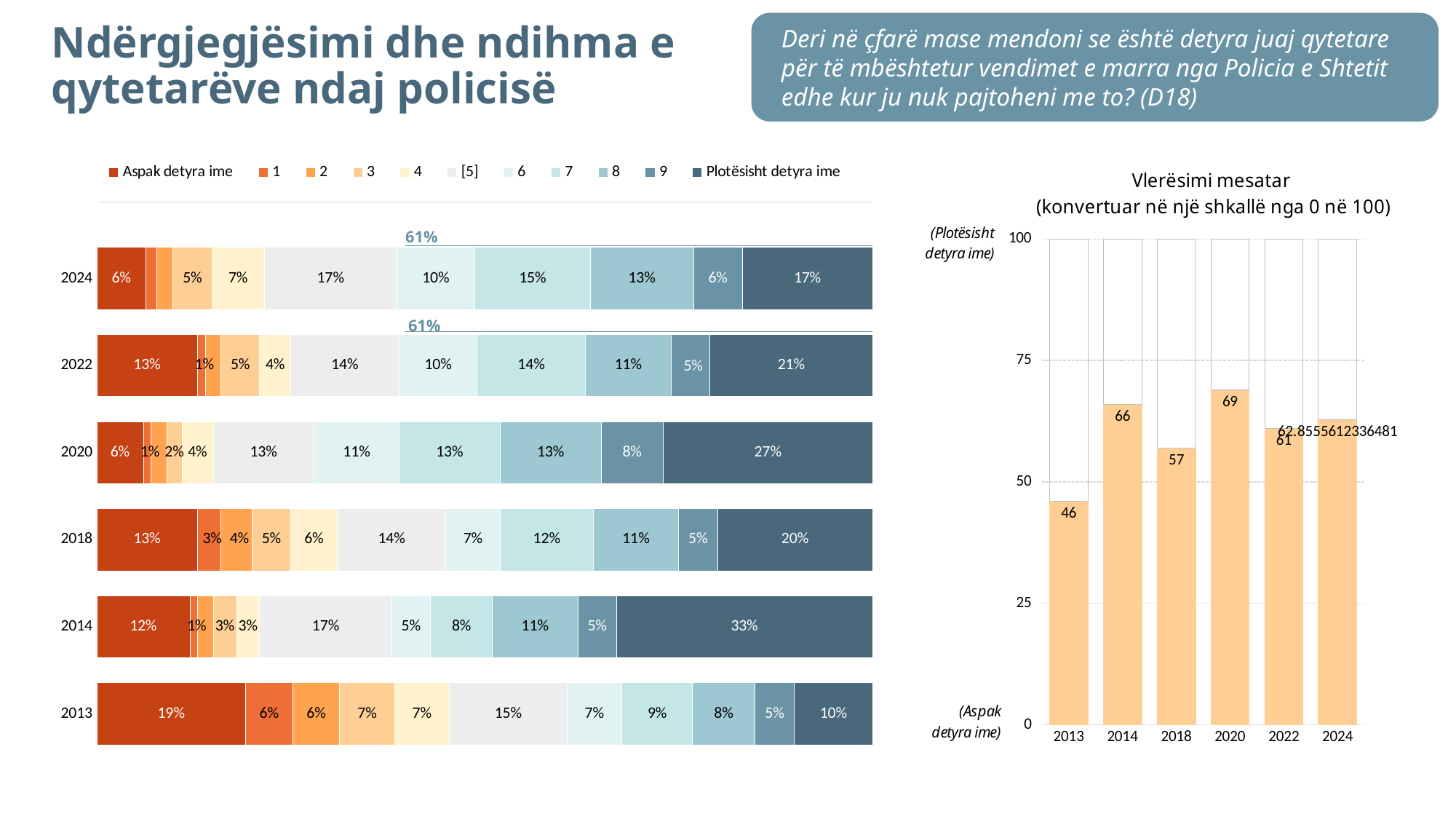
In the 'Vlerësimi mesatar' chart, what is the difference between the values for 2020 and 2018? 12 In the stacked bar chart on the left, which year has the largest 'Plotësisht detyra ime' share? 2014 In the stacked bar chart on the left, what is the 'Aspak detyra ime' share for 2013? 19% What kind of chart is the 'Vlerësimi mesatar' chart? bar chart In the stacked bar chart on the left, is the 'Aspak detyra ime' share larger for 2022 or for 2024? 2022 In the 'Vlerësimi mesatar' chart, how many years are shown on the x axis? 6 In the 'Vlerësimi mesatar' chart, is the value for 2014 greater or less than 50? greater In the 'Vlerësimi mesatar' chart, which year has the lowest value? 2013 In the stacked bar chart on the left, what is the 'Plotësisht detyra ime' share for 2014? 33% In the 'Vlerësimi mesatar' chart, which year has the highest value? 2020 In the 'Vlerësimi mesatar' chart, what is the value for 2013? 46 How many series does the legend of the stacked bar chart on the left list? 11